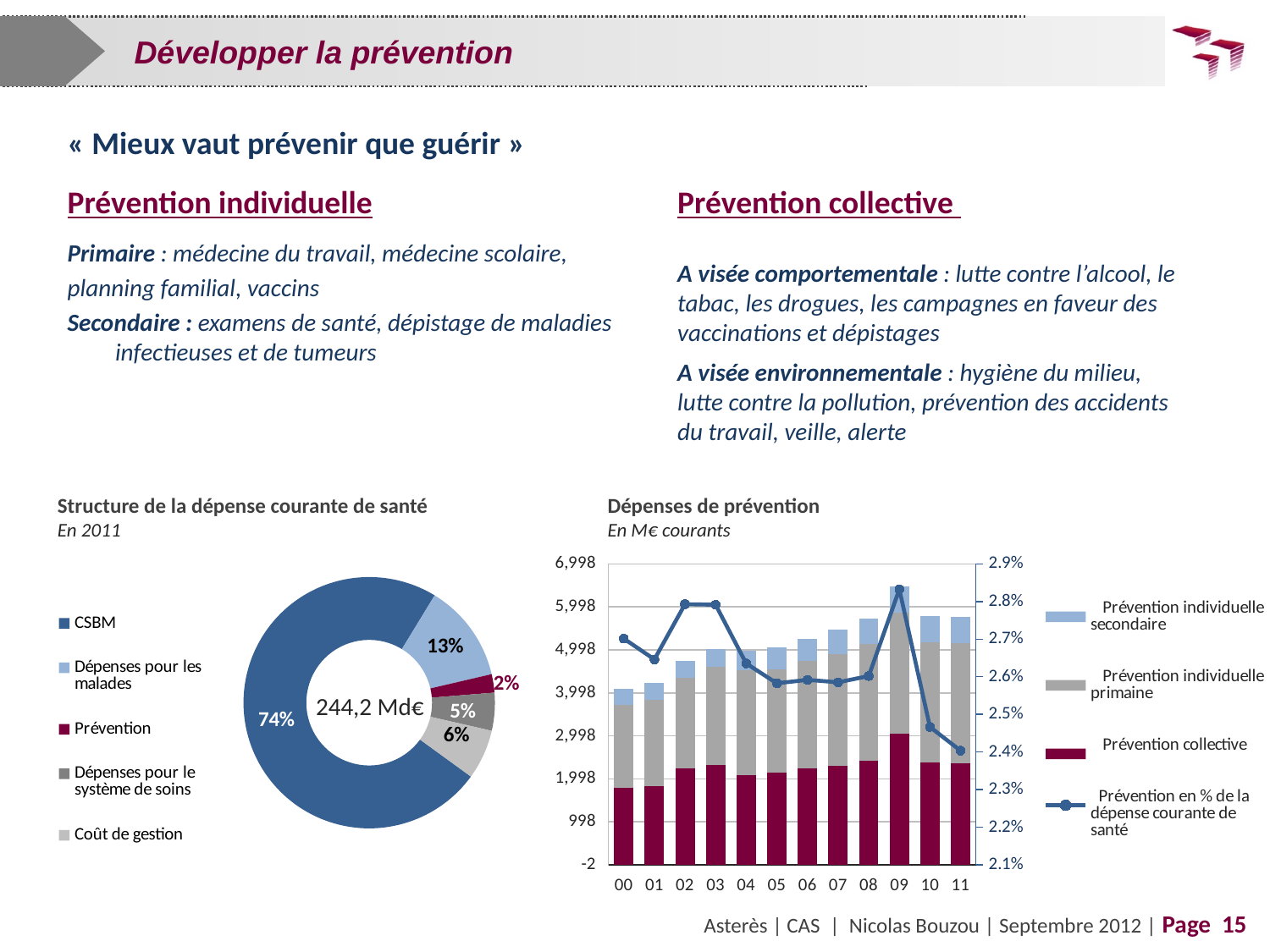
In the chart 'Structure de la dépense courante de santé', what is the difference in percentage points between CSBM and Dépenses pour les malades? 61 percentage points In the chart 'Structure de la dépense courante de santé', what share does Prévention represent? 2% In the chart 'Structure de la dépense courante de santé', what total amount is shown in the centre of the donut? 244,2 Md€ In the chart 'Dépenses de prévention', how many years are shown on the x axis? 12 In the chart 'Structure de la dépense courante de santé', which category has the largest share? CSBM In the chart 'Structure de la dépense courante de santé', what share do Dépenses pour les malades represent? 13% In the chart 'Dépenses de prévention', in which year does the line 'Prévention en % de la dépense courante de santé' reach its highest point? 09 In the chart 'Structure de la dépense courante de santé', which category has the smallest share? Prévention What kind of chart is 'Structure de la dépense courante de santé'? Donut (pie) chart In the chart 'Structure de la dépense courante de santé', what share does CSBM represent? 74% In the chart 'Dépenses de prévention', how many series does the legend list? 4 In the chart 'Dépenses de prévention', is the value of 'Prévention en % de la dépense courante de santé' in 11 greater or less than 2.5%? less